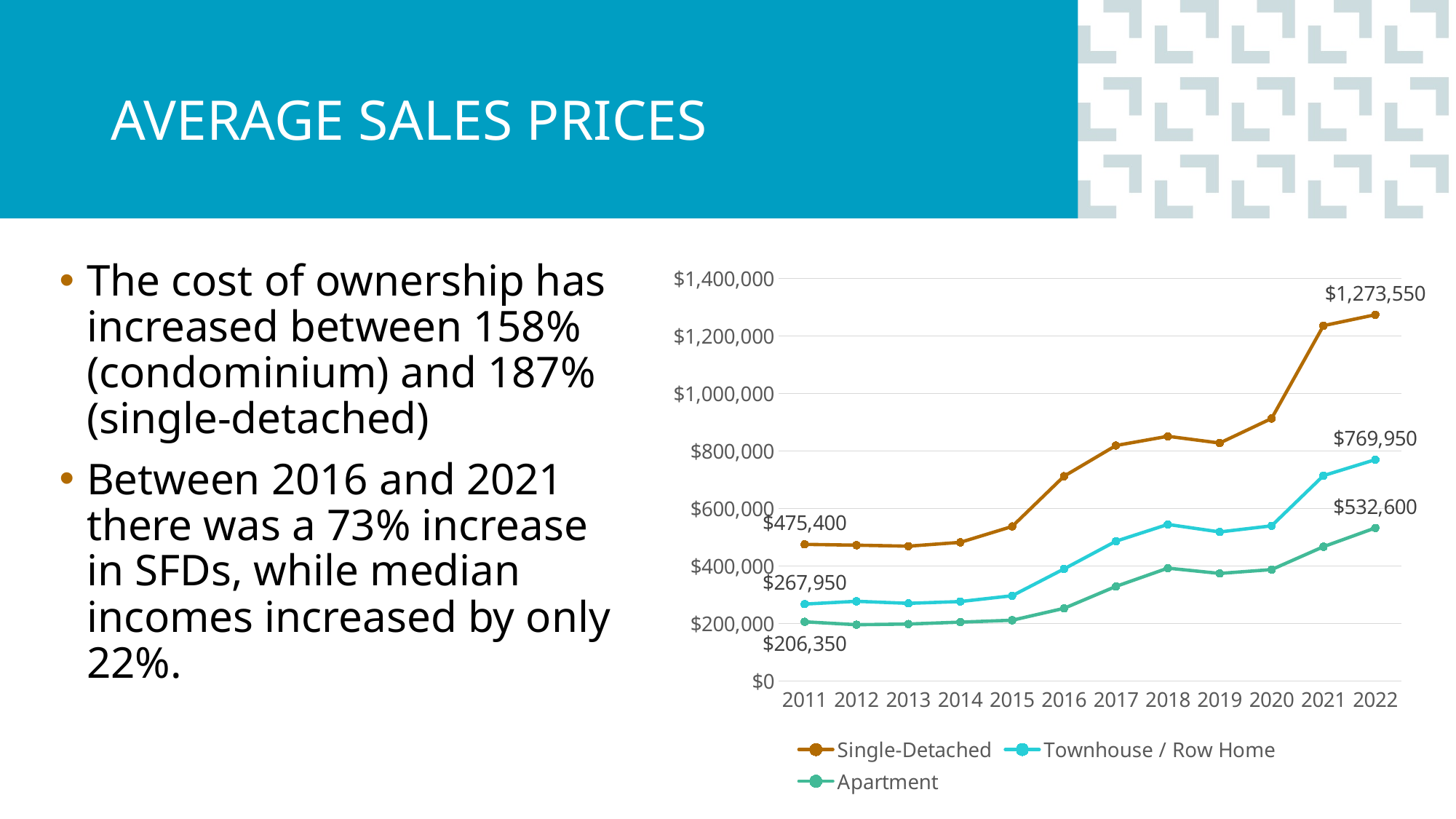
Is the Single-Detached average sales price in 2016 greater or less than $600,000? greater By how much did the Single-Detached average sales price increase from 2011 to 2022? $798,150 What was the average sales price for Apartments in 2011? $206,350 What is the difference between the Single-Detached and Townhouse / Row Home average sales prices in 2022? $503,600 What kind of chart is shown on the slide? Line chart Which series has the highest average sales price in 2022? Single-Detached How many series does the chart's legend list? 3 Which series has the lowest average sales price in 2011? Apartment How many years are shown on the x axis of the chart? 12 What was the average sales price for Single-Detached homes in 2011? $475,400 What was the average sales price for Single-Detached homes in 2022? $1,273,550 What was the average sales price for Townhouse / Row Homes in 2022? $769,950